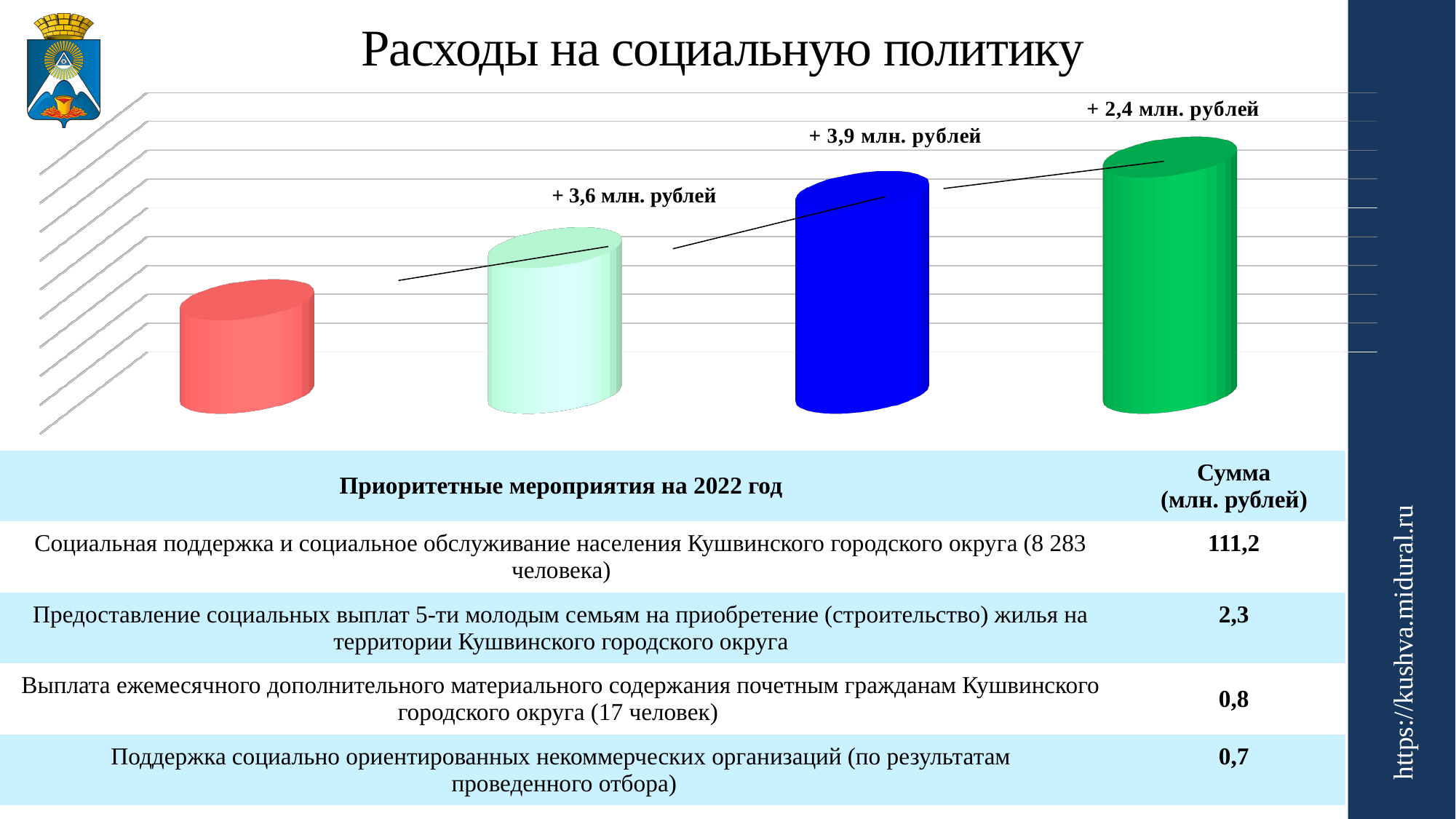
What kind of chart is shown on the slide? bar chart Do the bar values rise or fall from left to right across the chart? rise Which bar is the shortest in the chart: the red, light green, blue or green one? red What increase is annotated above the fourth (green) bar? + 2,4 млн. рублей Which bar is the tallest in the chart: the red, light green, blue or green one? green What is the title of the slide chart? Расходы на социальную политику What increase is annotated above the second (light green) bar? + 3,6 млн. рублей What colour is the first (leftmost) bar in the chart? red What increase is annotated above the third (blue) bar? + 3,9 млн. рублей Which bar is taller, the blue one or the red one? blue How many bars are plotted in the chart? 4 Which bar is taller, the light green (second) one or the blue (third) one? blue